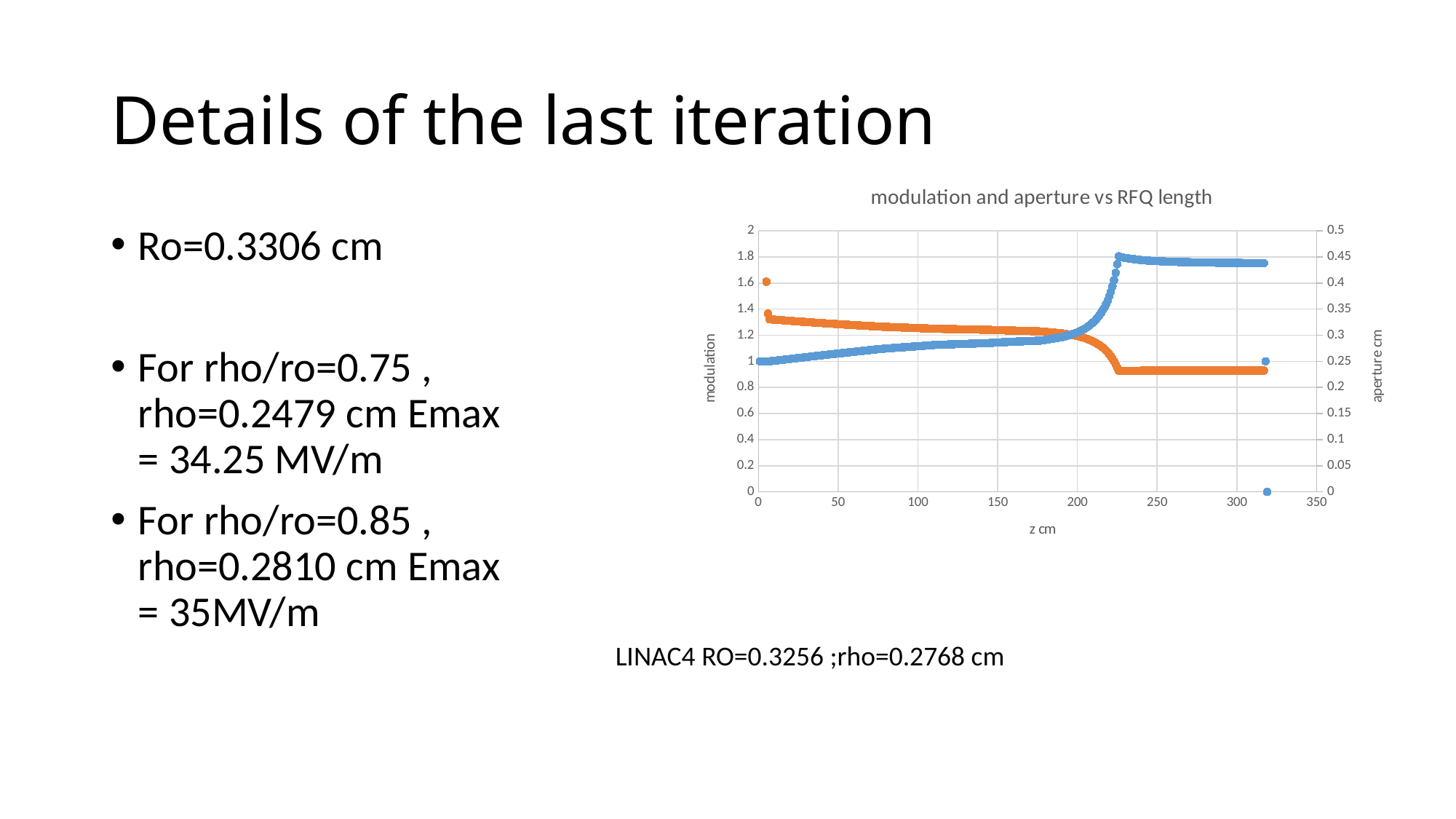
Is the modulation value (blue series) at z = 250 cm greater or less than 1.6 on the left axis? greater What is the title of the chart? modulation and aperture vs RFQ length Is the aperture value (orange series) at z = 300 cm greater or less than 0.25 on the right axis? less Does the orange (aperture) series rise or fall as z increases along the x axis? fall Does the blue (modulation) series rise or fall as z increases along the x axis? rise Is the aperture value (orange series) at z = 100 cm greater or less than 0.25 on the right axis? greater What is the highest tick value shown on the x axis of the chart? 350 What kind of chart is shown on the slide? scatter chart What is the label of the x axis of the chart? z cm Which series has the higher value on its own axis scale at z = 300 cm: the blue modulation series (left axis) or the orange aperture series (right axis)? blue modulation series